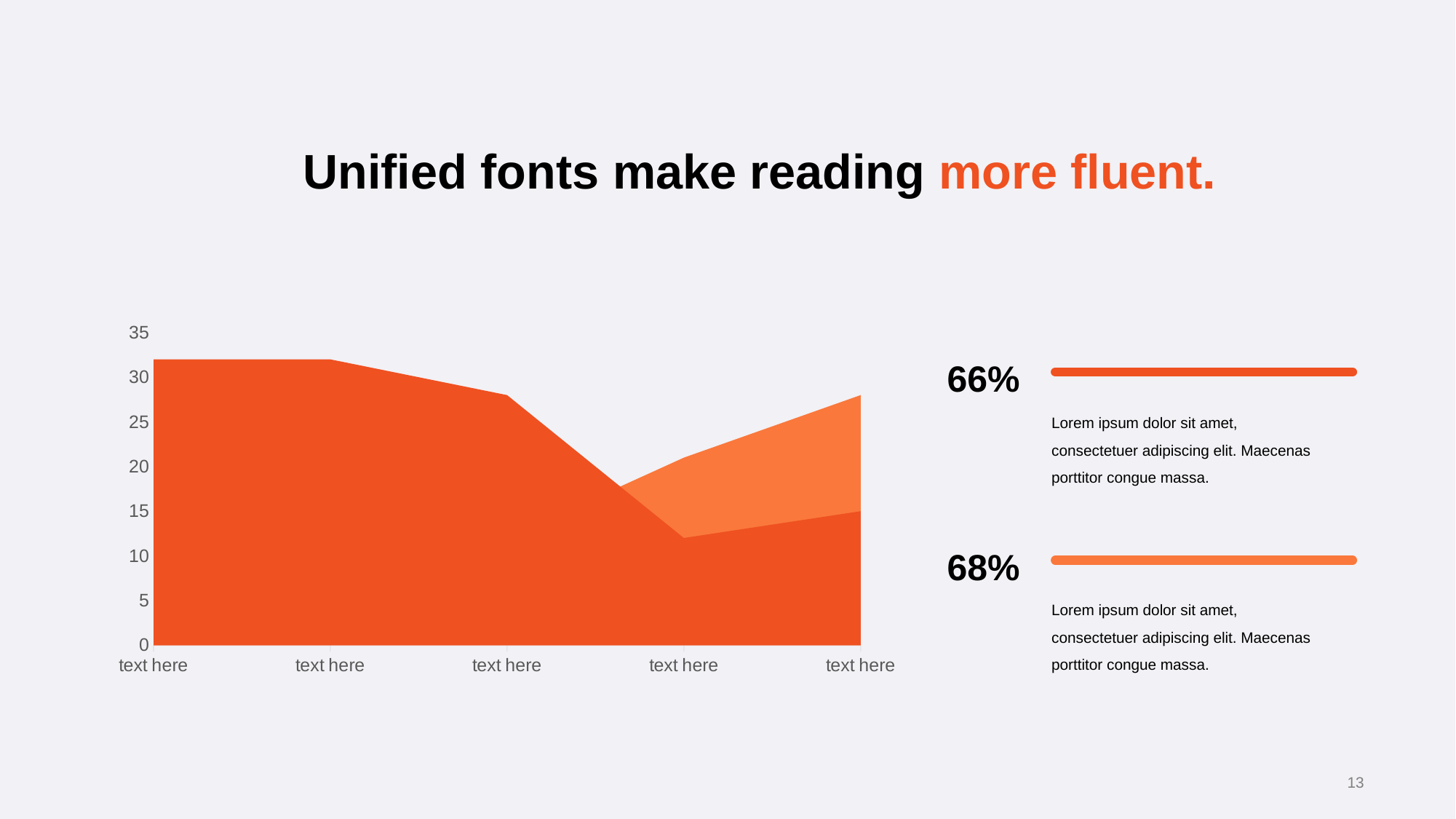
Is the value of the darker orange series at the third x-axis category greater or less than 25? greater Is the value of the lighter orange series at the fourth x-axis category greater or less than 15? greater What kind of chart is shown on the slide? area chart For the darker orange series, is the value at the first category or at the last category larger? the first category Does the lighter orange series rise or fall from the fourth category to the fifth category? rise Is the value of the darker orange series at the fourth x-axis category greater or less than 15? less How many categories are shown along the x axis of the chart? 5 At which x-axis position does the darker orange series reach its lowest value? the fourth category What is the highest value shown on the chart's vertical axis? 35 Does the darker orange series rise or fall from the second category to the fourth category? fall